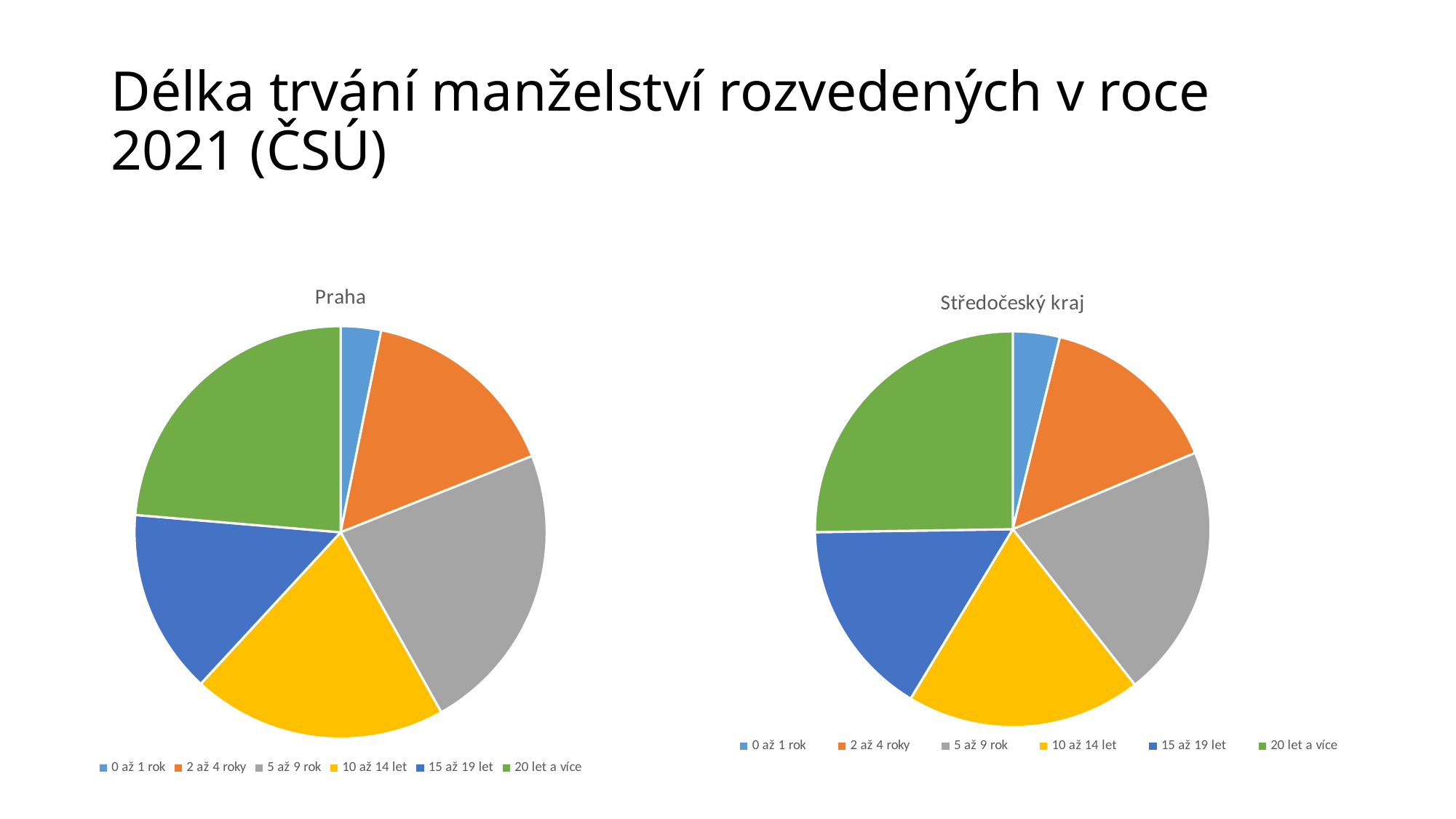
In the Praha chart, which category has the smallest slice? 0 až 1 rok What kind of chart is the Praha chart? pie chart In the Středočeský kraj chart, which category has the smallest slice? 0 až 1 rok How many slices does the Praha pie chart have? 6 In the Středočeský kraj chart, which slice is larger: 20 let a více or 2 až 4 roky? 20 let a více In the Praha chart, which slice is larger: 5 až 9 rok or 2 až 4 roky? 5 až 9 rok In the Středočeský kraj chart, which slice is larger: 0 až 1 rok or 10 až 14 let? 10 až 14 let How many entries does the legend of the Středočeský kraj chart list? 6 What is the title of the left pie chart? Praha What kind of chart is the Středočeský kraj chart? pie chart In the Středočeský kraj chart, what colour is the slice for 20 let a více? green